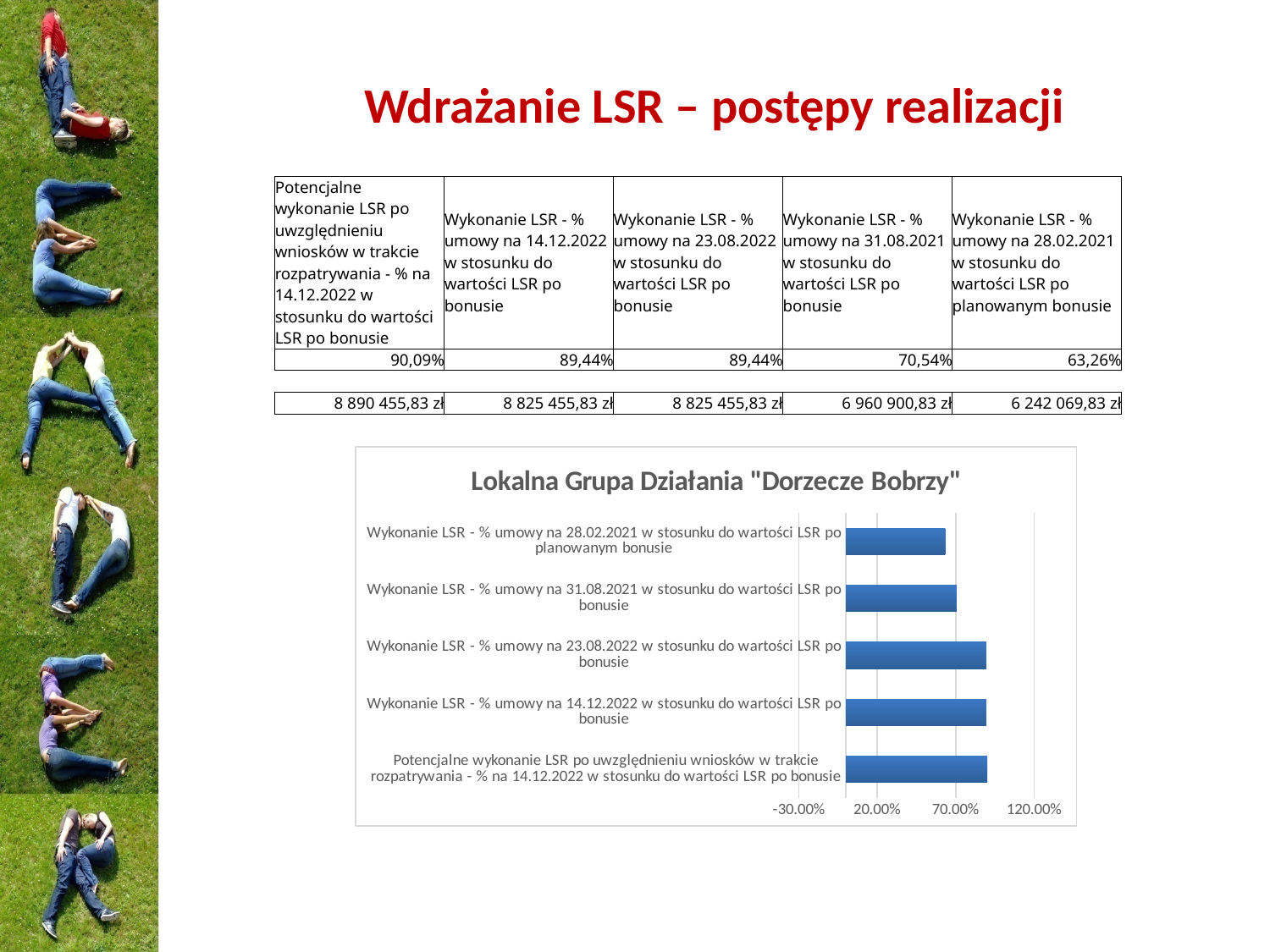
What kind of chart is shown on the slide? bar chart Is the value for "Potencjalne wykonanie LSR po uwzględnieniu wniosków w trakcie rozpatrywania - % na 14.12.2022 w stosunku do wartości LSR po bonusie" greater or less than 120.00%? less How many categories (bars) does the chart show? 5 Is the value for "Wykonanie LSR - % umowy na 28.02.2021 w stosunku do wartości LSR po planowanym bonusie" greater or less than 70.00%? less According to the table, what is the value of "Potencjalne wykonanie LSR po uwzględnieniu wniosków w trakcie rozpatrywania - % na 14.12.2022 w stosunku do wartości LSR po bonusie"? 90,09% What is the title of the chart? Lokalna Grupa Działania "Dorzecze Bobrzy" Which category has the lowest value in the chart? Wykonanie LSR - % umowy na 28.02.2021 w stosunku do wartości LSR po planowanym bonusie Is the value for "Wykonanie LSR - % umowy na 23.08.2022 w stosunku do wartości LSR po bonusie" greater or less than 70.00%? greater Which is larger: the value for 31.08.2021 (w stosunku do wartości LSR po bonusie) or the value for 28.02.2021 (w stosunku do wartości LSR po planowanym bonusie)? 31.08.2021 According to the table, what is the value of "Wykonanie LSR - % umowy na 31.08.2021 w stosunku do wartości LSR po bonusie"? 70,54% According to the table, what is the difference in percentage points between the 31.08.2021 value (70,54%) and the 28.02.2021 value (63,26%)? 7,28 What is the highest tick value shown on the chart's horizontal axis? 120.00%